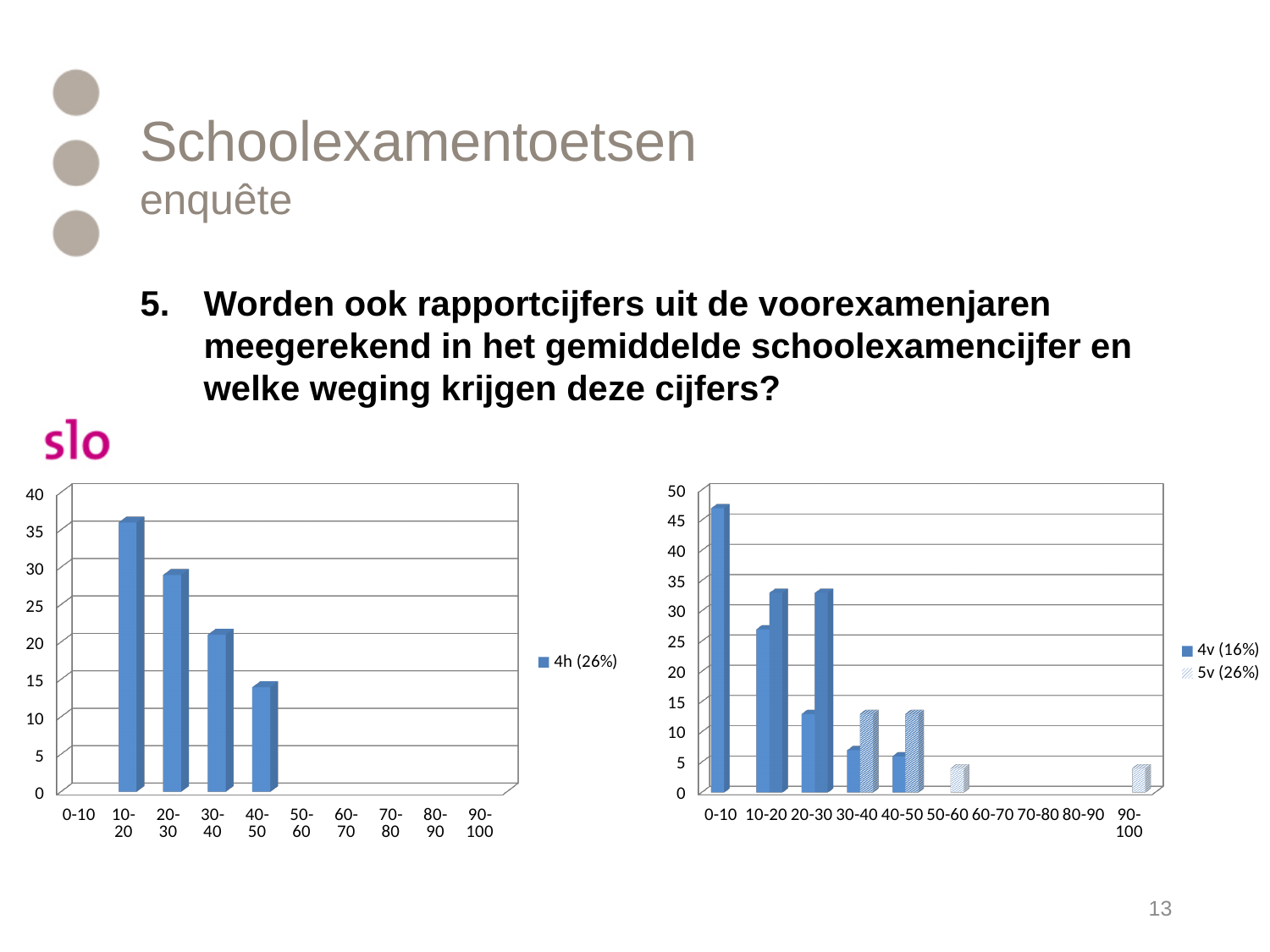
In the left chart, is the value for 10-20 greater or less than 30? greater In the right chart, is the value for 4v (16%) in 0-10 greater or less than 45? greater How many categories are shown on the x axis of the left chart? 10 In the left chart, which category has the highest value for 4h (26%)? 10-20 How many series does the legend of the right chart list? 2 In the right chart, is the value for 5v (26%) in 30-40 greater or less than 10? greater What is the legend entry of the left chart? 4h (26%) In the right chart, which category has the highest value for 4v (16%)? 0-10 In the right chart, which is larger for 20-30: 4v (16%) or 5v (26%)? 5v (26%) What kind of chart is the right chart? bar chart In the left chart, do the bar values rise or fall from 10-20 to 40-50? fall